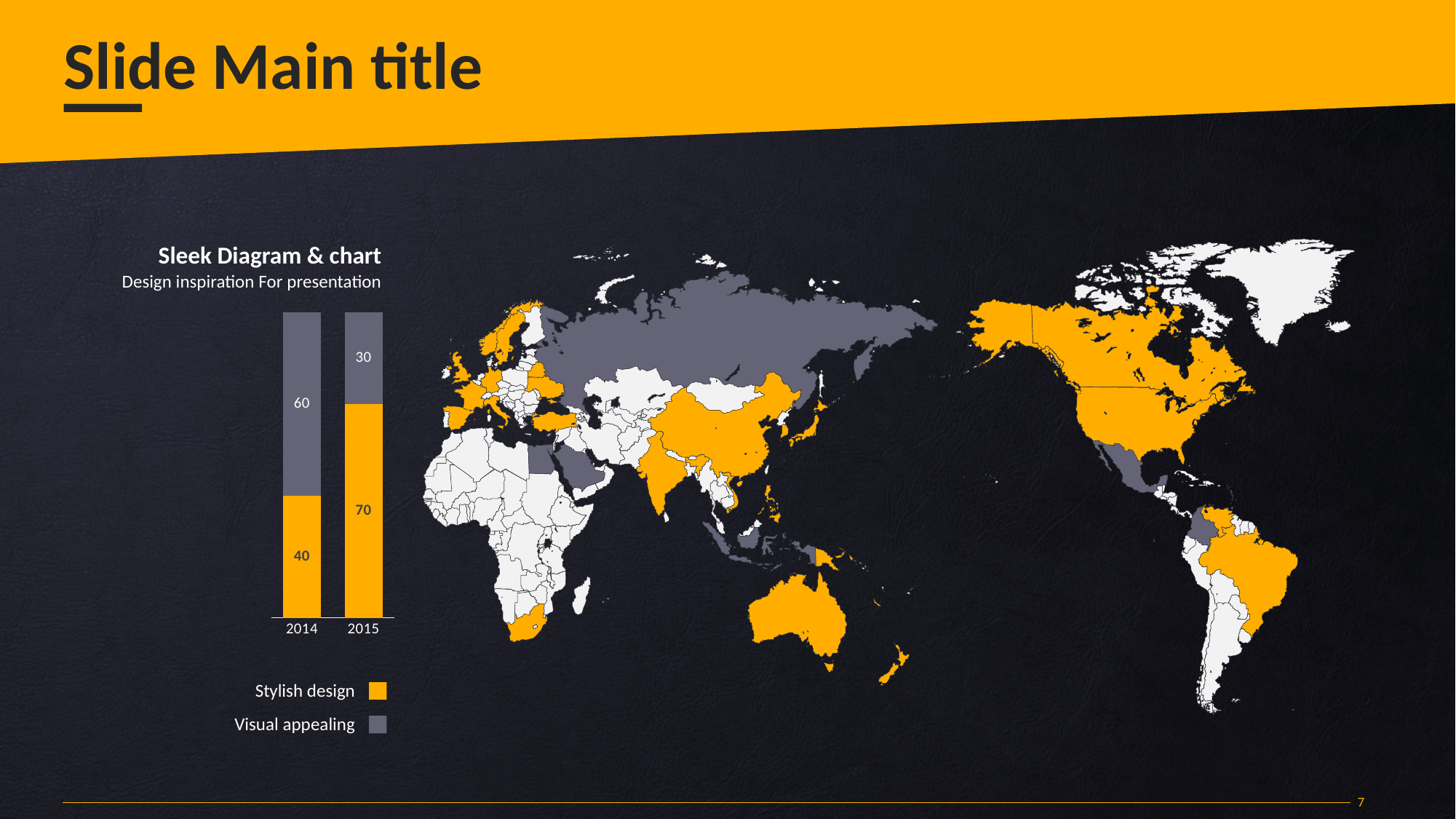
What is the difference between the Stylish design values for 2015 and 2014? 30 How many series does the legend list? 2 Which year has the higher Visual appealing value? 2014 What is the value for Visual appealing in 2015? 30 What kind of chart is shown? stacked bar chart What is the value for Visual appealing in 2014? 60 Does the Stylish design value rise or fall from 2014 to 2015? rise What is the value for Stylish design in 2015? 70 What is the value for Stylish design in 2014? 40 What is the total of the stacked bar for 2014? 100 How many categories are shown on the x axis? 2 What is the total of the stacked bar for 2015? 100